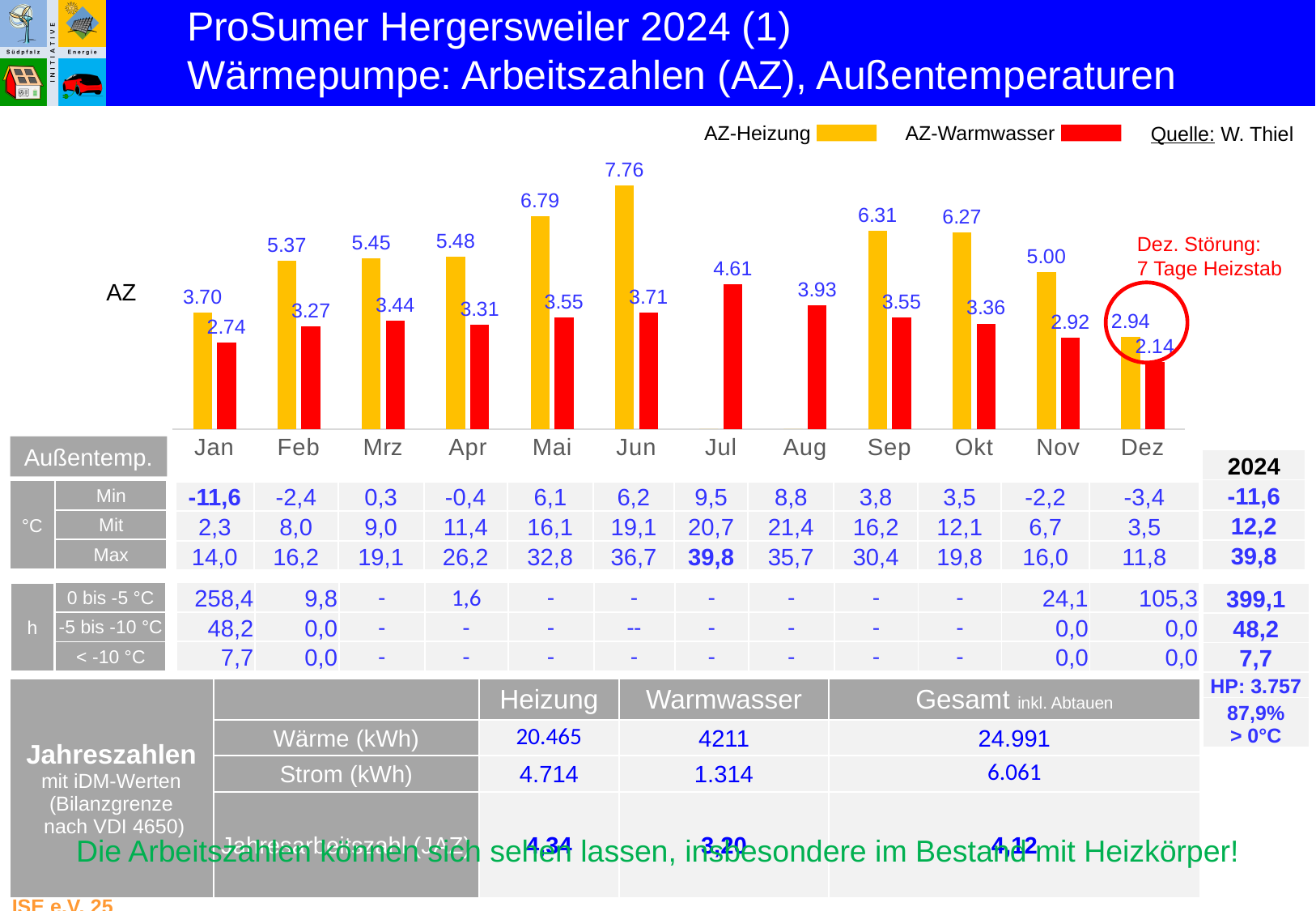
Which month has the highest AZ-Heizung value? Jun Which is larger, the AZ-Heizung value for Sep or for Nov? Sep What is the AZ-Heizung value for Dez? 2.94 How many series does the chart legend list? 2 What type of chart is shown on the slide? bar chart Which month has the highest AZ-Warmwasser value? Jul What is the AZ-Heizung value for Jun? 7.76 What is the difference between the AZ-Heizung and AZ-Warmwasser values for Mai? 3.24 How many months are shown on the x axis of the chart? 12 Which month has the lowest AZ-Warmwasser value? Dez Which colour represents AZ-Warmwasser in the chart? red What is the AZ-Warmwasser value for Jul? 4.61